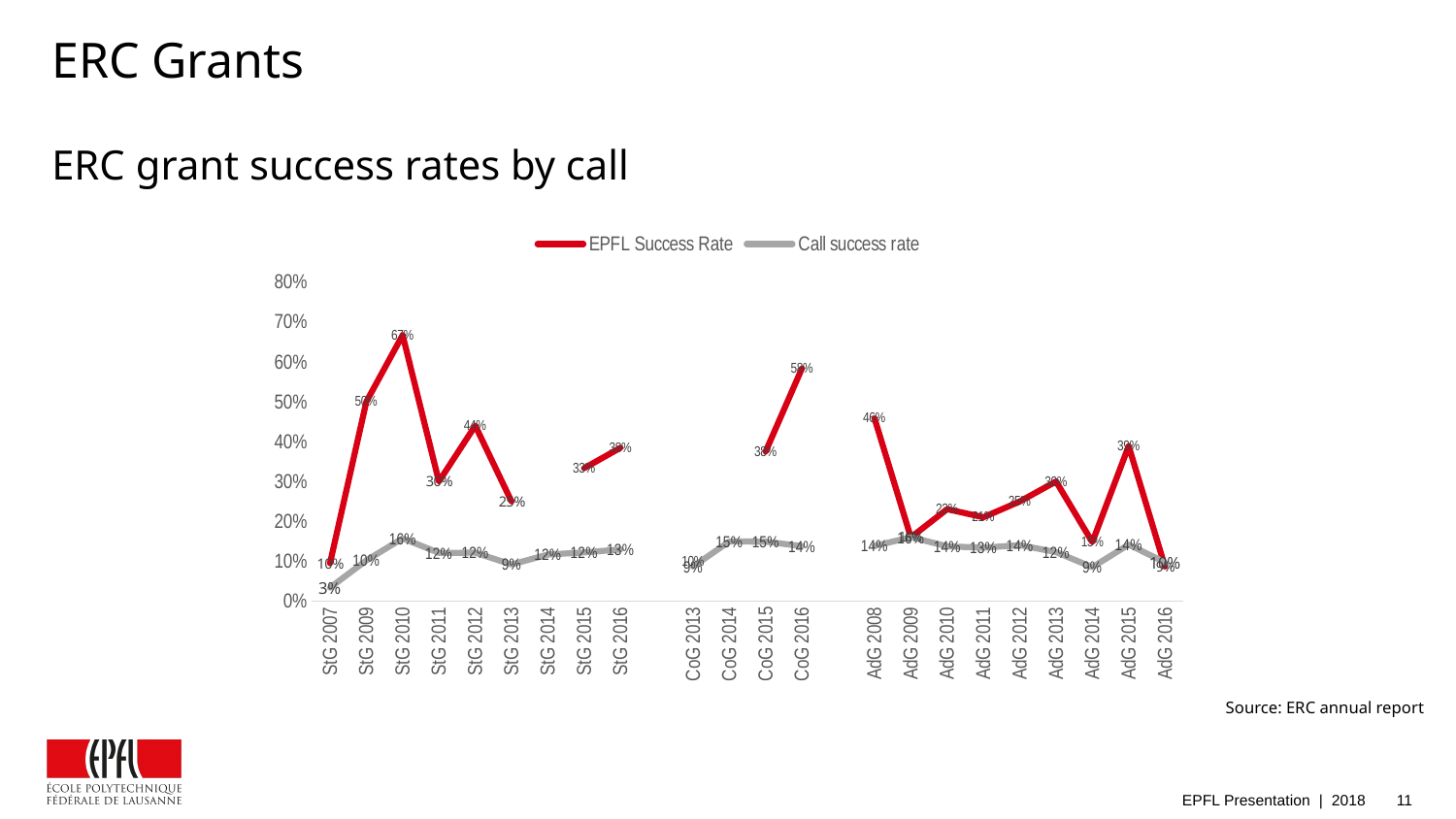
What is the difference between the EPFL Success Rate and the Call success rate for StG 2010? 51 percentage points What is the EPFL Success Rate for StG 2015? 33% How many calls (categories) are shown on the x axis? 22 Which call has the lowest Call success rate? StG 2007 What is the Call success rate for StG 2007? 3% How many series does the legend list? 2 Which call has the highest EPFL Success Rate? StG 2010 Is the EPFL Success Rate for CoG 2016 greater or less than 50%? greater Which series is drawn in red? EPFL Success Rate What is the Call success rate for StG 2010? 16% What is the EPFL Success Rate for StG 2010? 67% What kind of chart is shown on the slide? Line chart